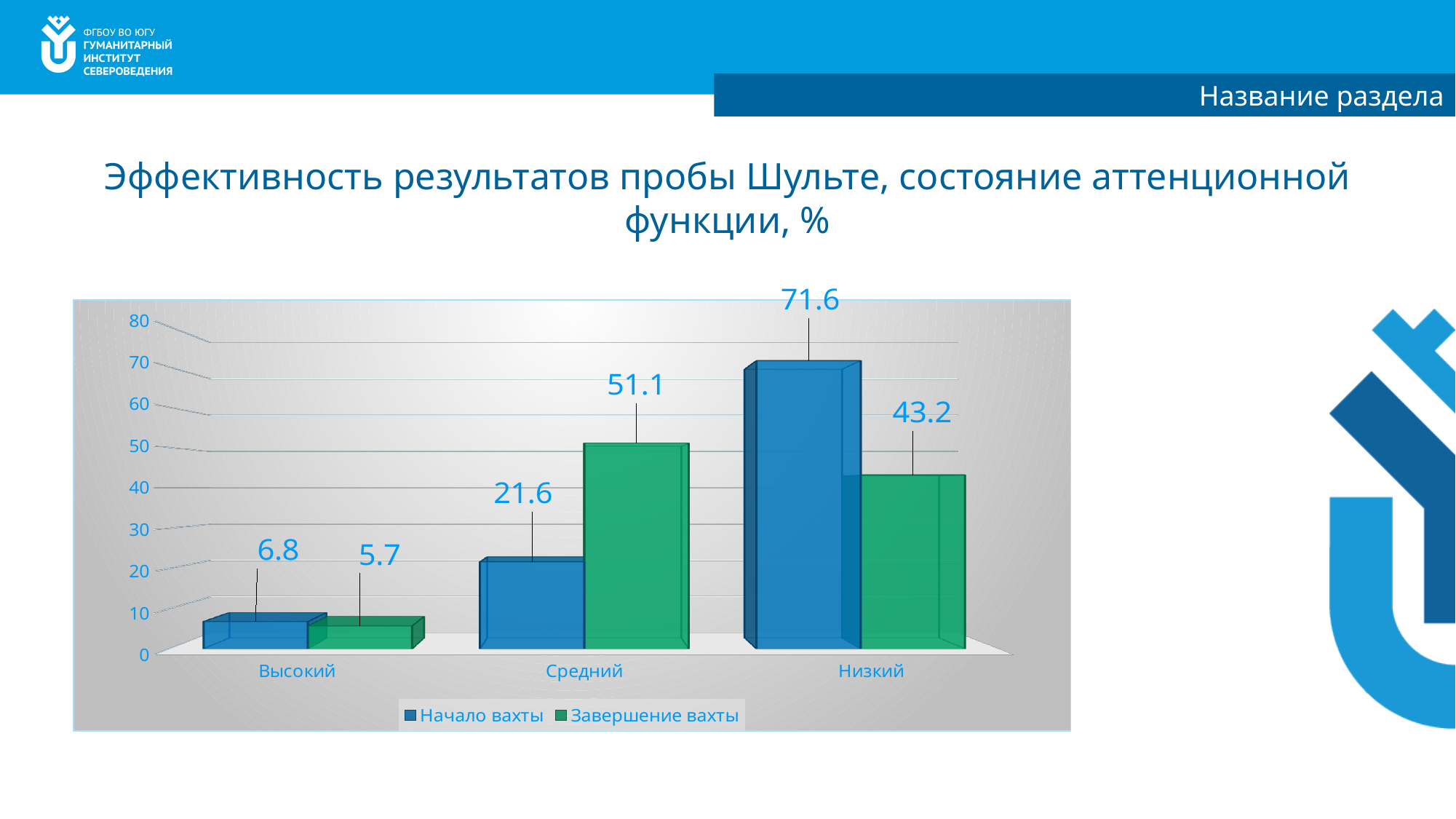
What is the difference between the Начало вахты and Завершение вахты values for Низкий? 28.4 What is the value for Низкий in the Завершение вахты series? 43.2 What is the value for Высокий in the Начало вахты series? 6.8 What is the value for Низкий in the Начало вахты series? 71.6 Which category has the lowest value in the Завершение вахты series? Высокий How many categories are shown on the x axis? 3 What is the value for Средний in the Завершение вахты series? 51.1 How many series does the legend list? 2 Which category has the highest value in the Начало вахты series? Низкий What is the difference between the Завершение вахты and Начало вахты values for Средний? 29.5 For Средний, which series has the larger value: Начало вахты or Завершение вахты? Завершение вахты What kind of chart is shown on the slide? Bar chart